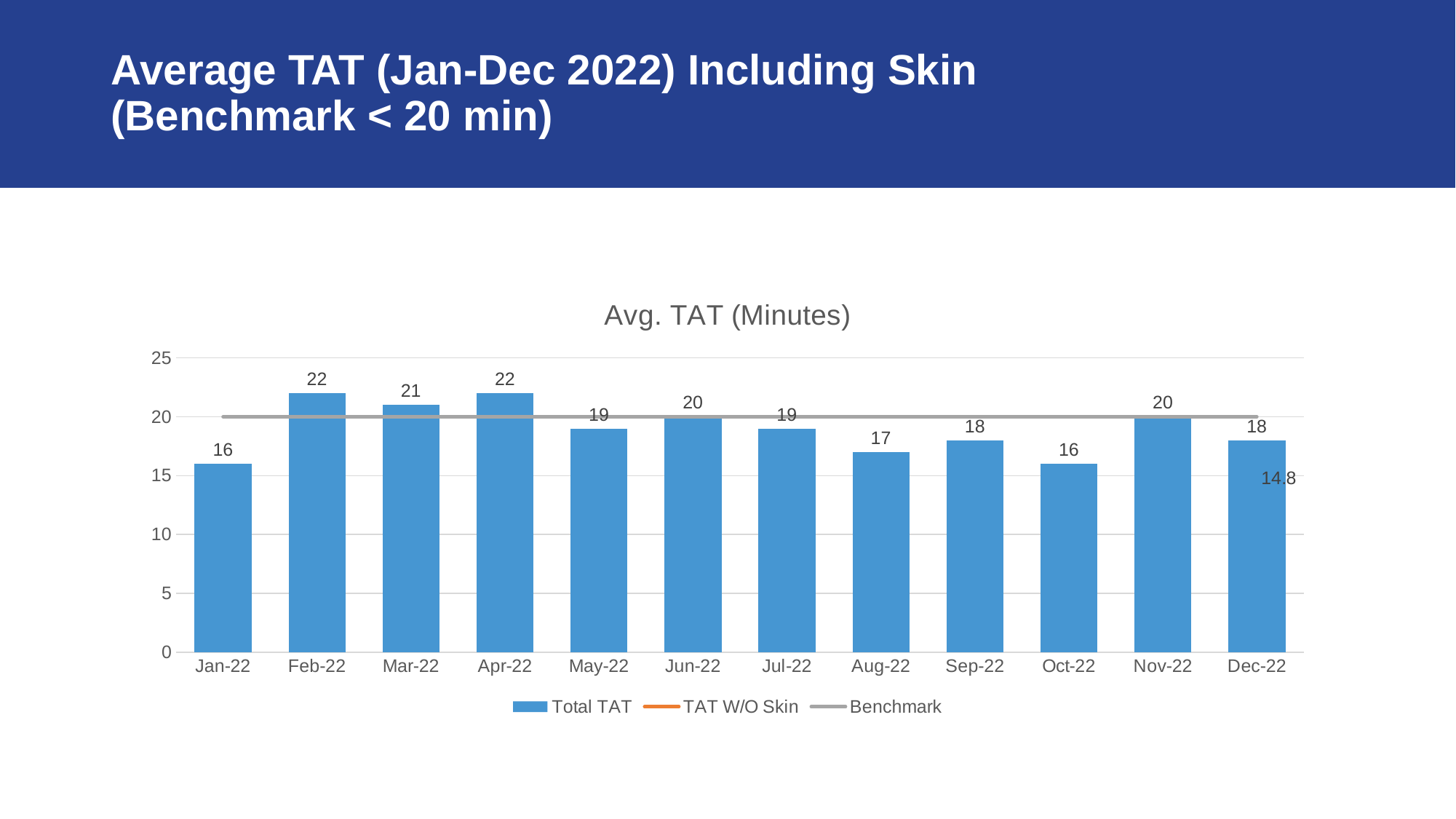
How many months are shown on the x axis of the chart? 12 How many series does the chart legend list? 3 What is the Total TAT value for Mar-22? 21 Which months have the highest Total TAT value? Feb-22 and Apr-22 What kind of chart is used to show the Total TAT values? Bar chart What is the difference between the Total TAT values for Feb-22 and Jan-22? 6 Which months have the lowest Total TAT value? Jan-22 and Oct-22 Is the Total TAT value for Apr-22 greater or less than 20? greater What is the Total TAT value for Nov-22? 20 What is the title of the chart? Avg. TAT (Minutes) What is the Total TAT value for Aug-22? 17 Which month has a larger Total TAT value, May-22 or Sep-22? May-22